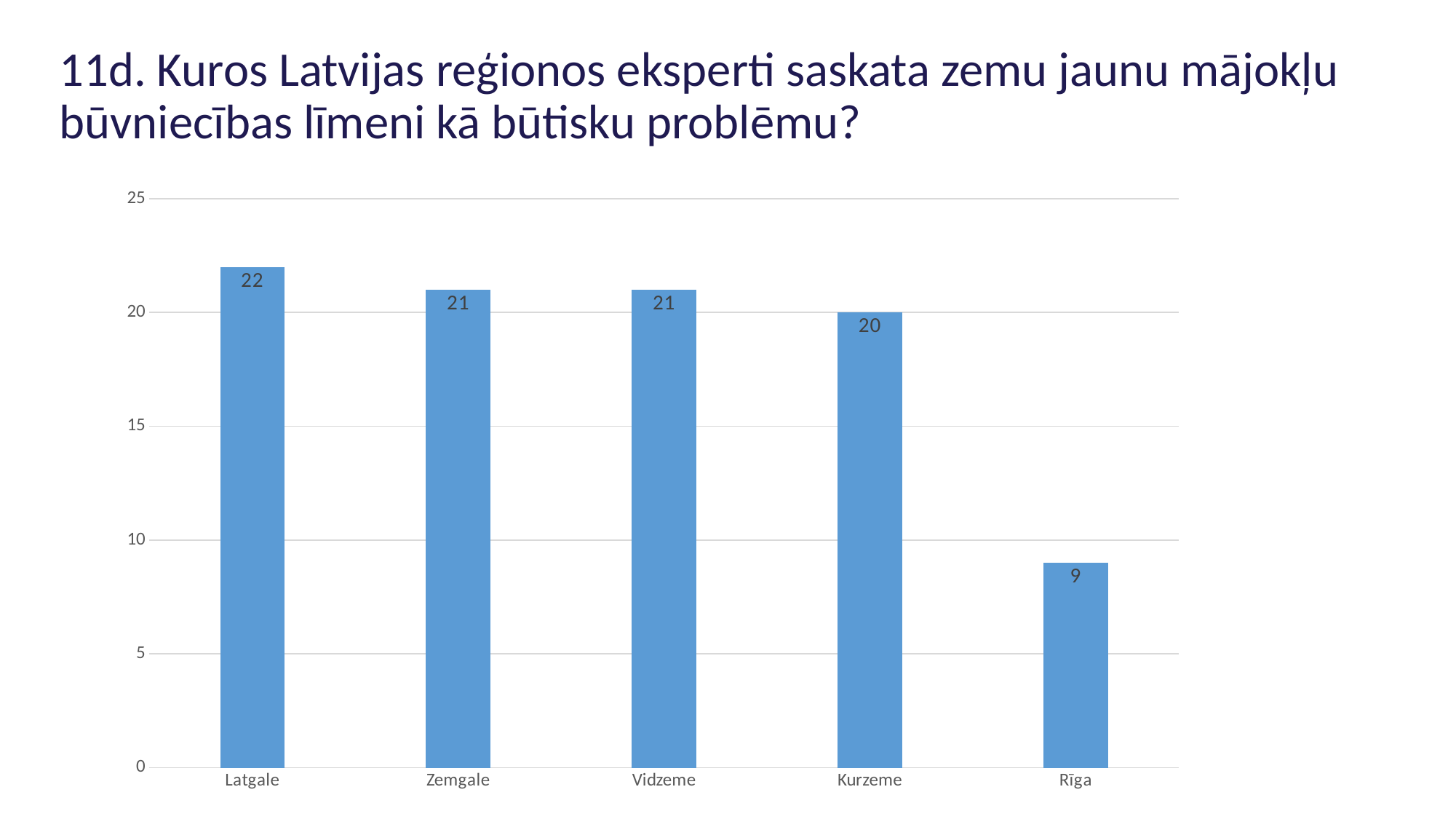
Is the value for Rīga greater or less than 10? less Which is larger, the value for Kurzeme or the value for Rīga? Kurzeme What is the value for Kurzeme? 20 What is the difference between the values for Zemgale and Kurzeme? 1 Which two regions have the same value of 21? Zemgale and Vidzeme What is the difference between the values for Latgale and Rīga? 13 How many regions are shown on the chart? 5 Which region has the highest value? Latgale Which region has the lowest value? Rīga What kind of chart is shown on the slide? bar chart What is the value for Rīga? 9 What is the value for Latgale? 22